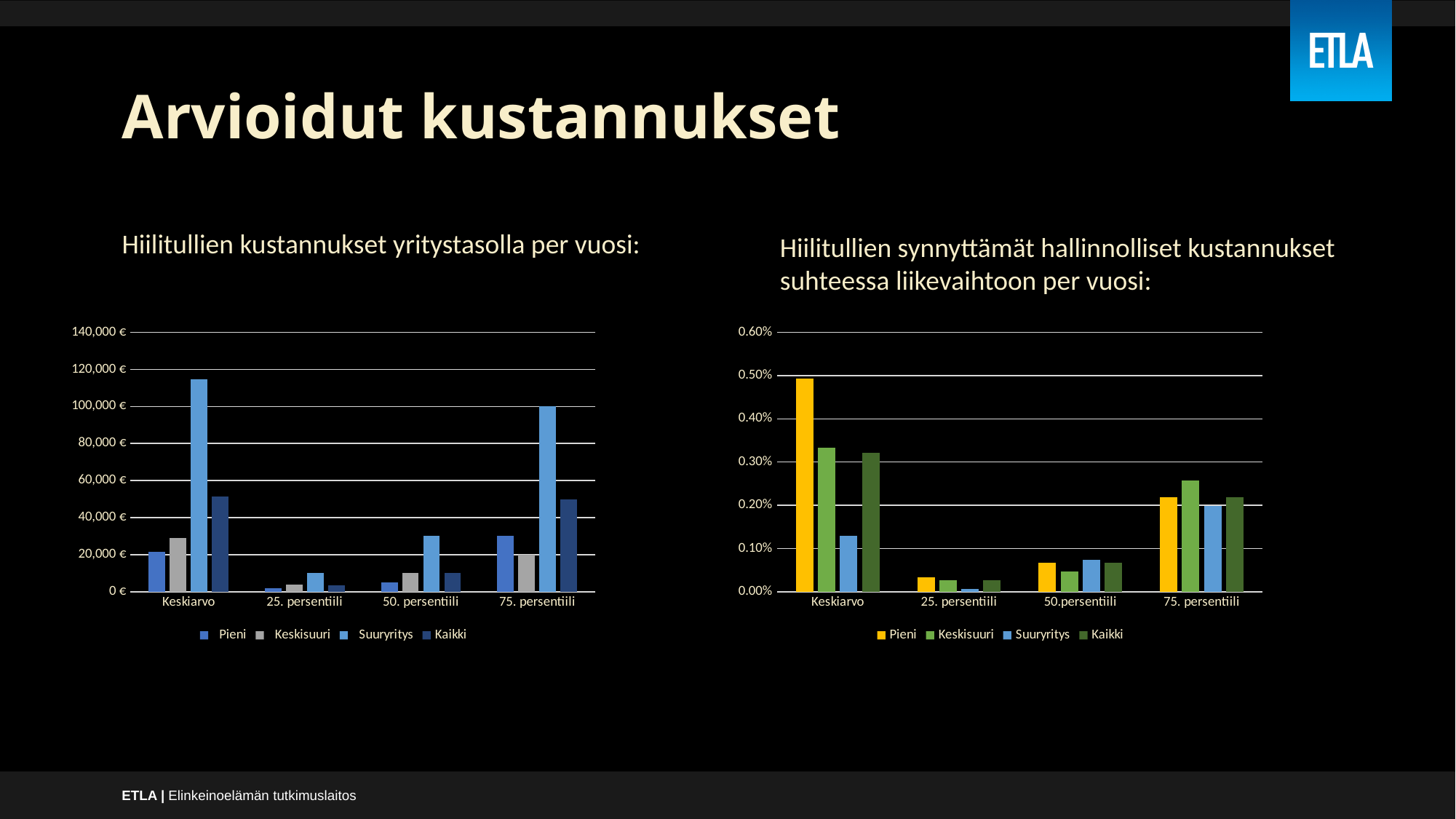
In the left chart, 'Hiilitullien kustannukset yritystasolla per vuosi', is the Suuryritys value for Keskiarvo greater or less than 100,000 €? greater In the right chart, 'Hiilitullien synnyttämät hallinnolliset kustannukset suhteessa liikevaihtoon per vuosi', which series has the lowest bar in the 25. persentiili category? Suuryritys In the left chart, 'Hiilitullien kustannukset yritystasolla per vuosi', which is larger for 75. persentiili: Suuryritys or Kaikki? Suuryritys What kind of chart is the left chart, 'Hiilitullien kustannukset yritystasolla per vuosi'? bar chart How many categories are shown on the x axis of the left chart, 'Hiilitullien kustannukset yritystasolla per vuosi'? 4 In the right chart, 'Hiilitullien synnyttämät hallinnolliset kustannukset suhteessa liikevaihtoon per vuosi', do the Pieni values rise or fall from 25. persentiili to 75. persentiili? rise In the right chart, 'Hiilitullien synnyttämät hallinnolliset kustannukset suhteessa liikevaihtoon per vuosi', which series has the highest bar in the Keskiarvo category? Pieni In the right chart, 'Hiilitullien synnyttämät hallinnolliset kustannukset suhteessa liikevaihtoon per vuosi', is the Pieni value for Keskiarvo greater or less than 0.40%? greater In the left chart, 'Hiilitullien kustannukset yritystasolla per vuosi', which series has the highest bar in the Keskiarvo category? Suuryritys In the right chart, 'Hiilitullien synnyttämät hallinnolliset kustannukset suhteessa liikevaihtoon per vuosi', is the Keskisuuri value for 75. persentiili greater or less than 0.20%? greater How many series does the legend of the right chart, 'Hiilitullien synnyttämät hallinnolliset kustannukset suhteessa liikevaihtoon per vuosi', list? 4